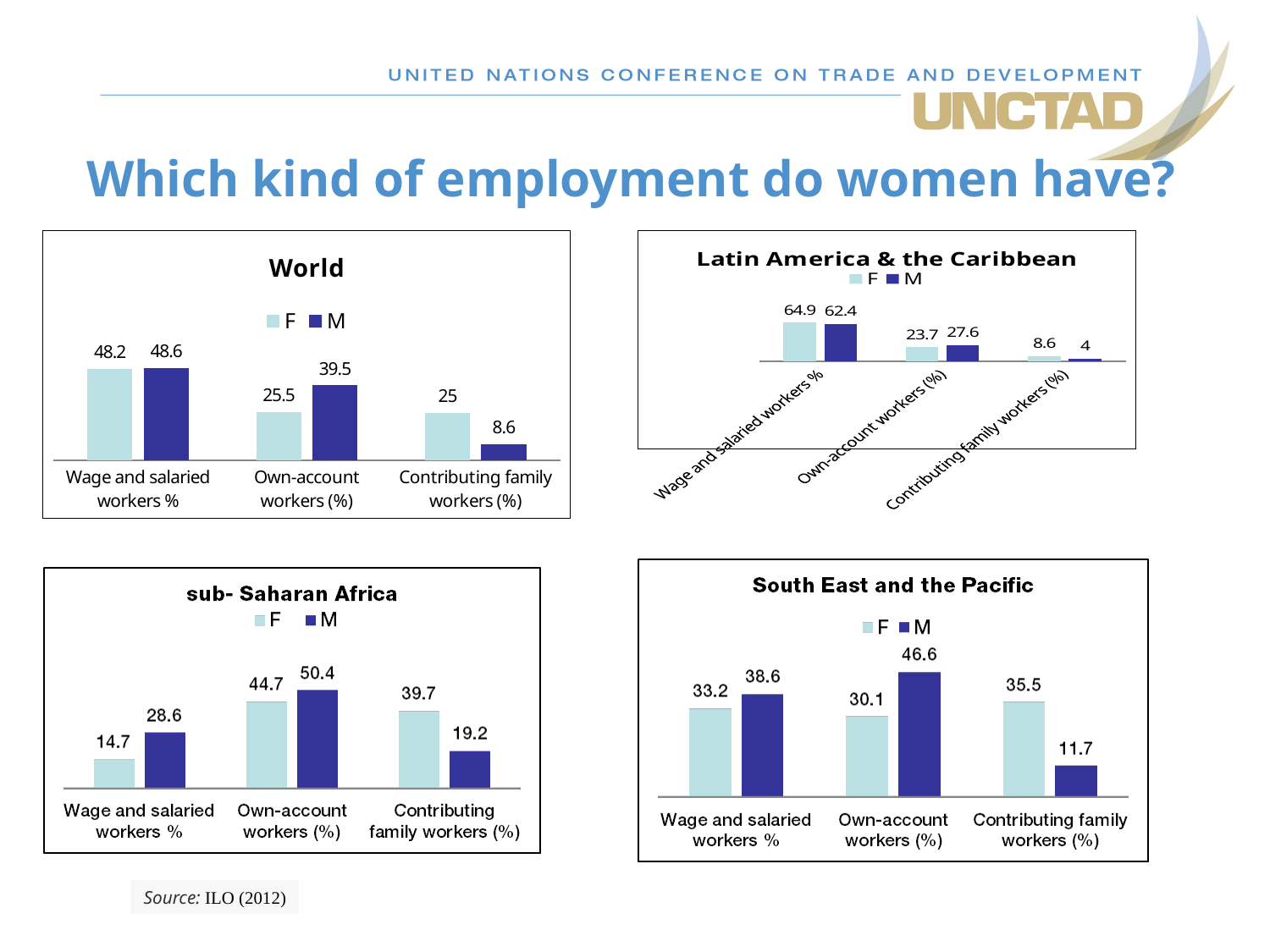
In the sub-Saharan Africa chart, what is the value for M in Own-account workers (%)? 50.4 In the World chart, what is the value for M in Contributing family workers (%)? 8.6 In the South East and the Pacific chart, which category has the highest M value? Own-account workers (%) In the World chart, what is the value for F in Own-account workers (%)? 25.5 In the Latin America & the Caribbean chart, what is the value for F in Wage and salaried workers %? 64.9 How many series does the legend list in the sub-Saharan Africa chart? 2 In the sub-Saharan Africa chart, which category has the lowest F value? Wage and salaried workers % What kind of chart is the South East and the Pacific chart? Bar chart In the Latin America & the Caribbean chart, what is the difference between F and M for Own-account workers (%)? 3.9 In the World chart, which is larger for Contributing family workers (%), F or M? F How many categories are shown in the Latin America & the Caribbean chart? 3 In the South East and the Pacific chart, what is the difference between F and M for Contributing family workers (%)? 23.8